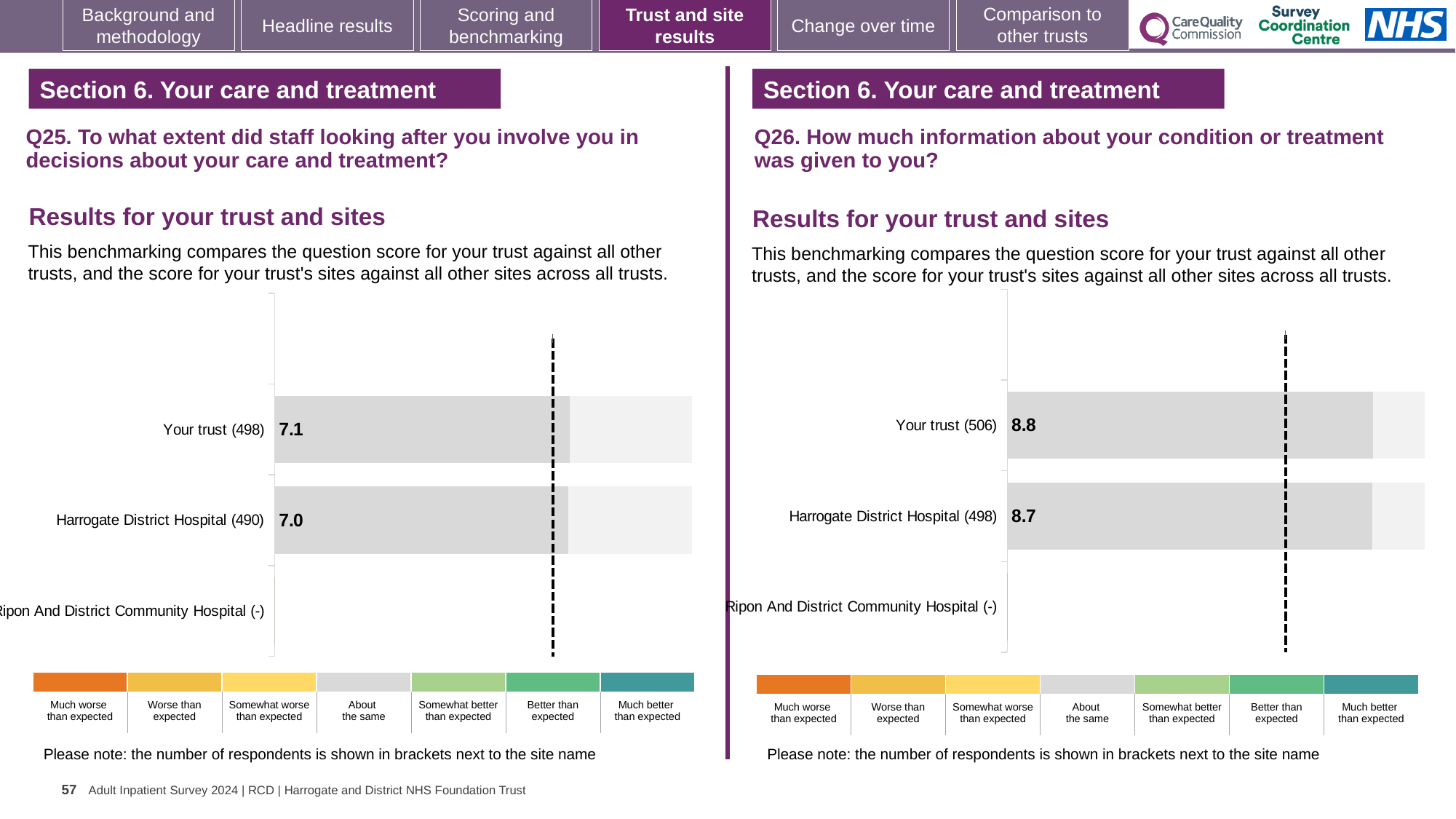
In the Q25 chart on the left, how many site or trust categories are listed on the vertical axis? 3 In the Q25 chart on the left, what is the difference between the score for Your trust and the score for Harrogate District Hospital? 0.1 In the Q26 chart on the right, what is the score for Your trust (506)? 8.8 In the Q26 chart on the right, which has the higher score, Your trust or Harrogate District Hospital? Your trust In the Q26 chart on the right, what is the score for Harrogate District Hospital (498)? 8.7 In the Q26 chart on the right, what is the difference between the score for Your trust and the score for Harrogate District Hospital? 0.1 What kind of chart is used on the left for Q25? Bar chart In the Q25 chart on the left, what is the score for Harrogate District Hospital (490)? 7.0 In the Q25 chart on the left, what is the score for Your trust (498)? 7.1 In the Q25 chart on the left, how many respondents are shown in brackets for Harrogate District Hospital? 490 Is the score for Your trust in the Q26 chart on the right greater or less than the score for Your trust in the Q25 chart on the left? greater In the Q26 chart on the right, how many respondents are shown in brackets for Your trust? 506